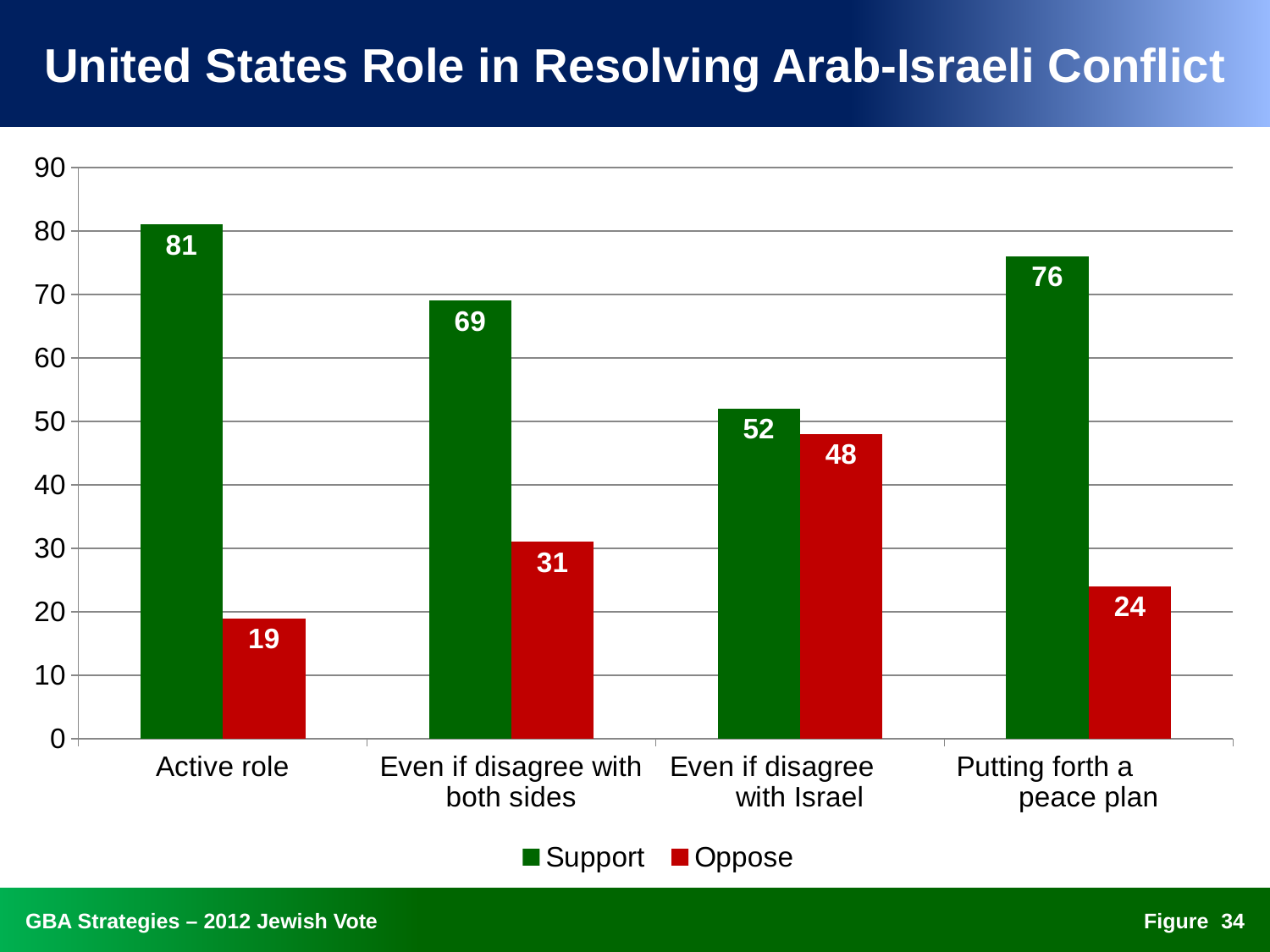
Which category has the lowest Oppose value? Active role How many categories are shown on the x axis? 4 Which is larger: the Support value for "Even if disagree with Israel" or the Oppose value for "Even if disagree with Israel"? Support What is the Oppose value for "Even if disagree with Israel"? 48 What is the Support value for "Active role"? 81 Which category has the highest Support value? Active role Is the Support value for "Putting forth a peace plan" greater or less than 70? greater How many series does the legend list? 2 What is the Oppose value for "Putting forth a peace plan"? 24 What is the difference between the Support and Oppose values for "Even if disagree with both sides"? 38 What kind of chart is shown on the slide? Bar chart What colour are the Oppose bars? Red